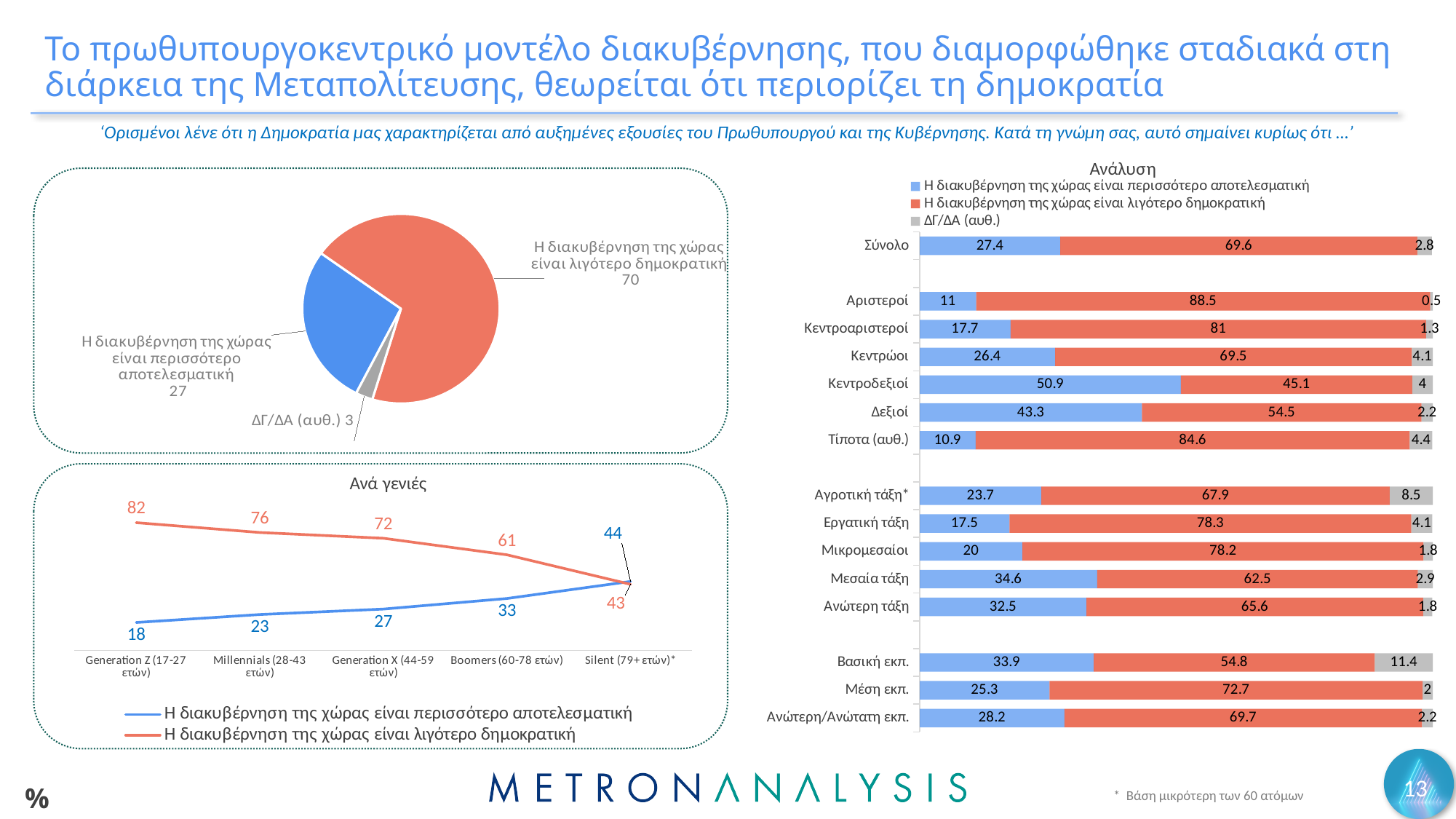
In the 'Ανάλυση' bar chart, which is larger for Δεξιοί: 'περισσότερο αποτελεσματική' or 'λιγότερο δημοκρατική'? Λιγότερο δημοκρατική What kind of chart is the chart on the top left of the slide? Pie chart In the 'Ανάλυση' bar chart, which category has the highest value for 'Η διακυβέρνηση της χώρας είναι περισσότερο αποτελεσματική'? Κεντροδεξιοί In the 'Ανά γενιές' chart, how many generation categories are shown on the x axis? 5 In the 'Ανάλυση' bar chart, what is the value of 'Η διακυβέρνηση της χώρας είναι λιγότερο δημοκρατική' for Αριστεροί? 88.5 In the 'Ανά γενιές' chart, what is the difference between the red and blue values for Boomers (60-78 ετών)? 28 In the 'Ανά γενιές' chart, does the blue line ('περισσότερο αποτελεσματική') rise or fall from Generation Z to Silent? Rise In the 'Ανά γενιές' chart, what is the value of the red line ('λιγότερο δημοκρατική') for Generation Z (17-27 ετών)? 82 In the pie chart on the top left, what value is shown for 'Η διακυβέρνηση της χώρας είναι λιγότερο δημοκρατική'? 70 In the 'Ανάλυση' bar chart, how many series does the legend list? 3 In the pie chart on the top left, what share of the pie does the 'ΔΓ/ΔΑ (αυθ.)' slice represent? 3% In the 'Ανάλυση' bar chart, which category has the highest 'ΔΓ/ΔΑ (αυθ.)' value? Βασική εκπ.